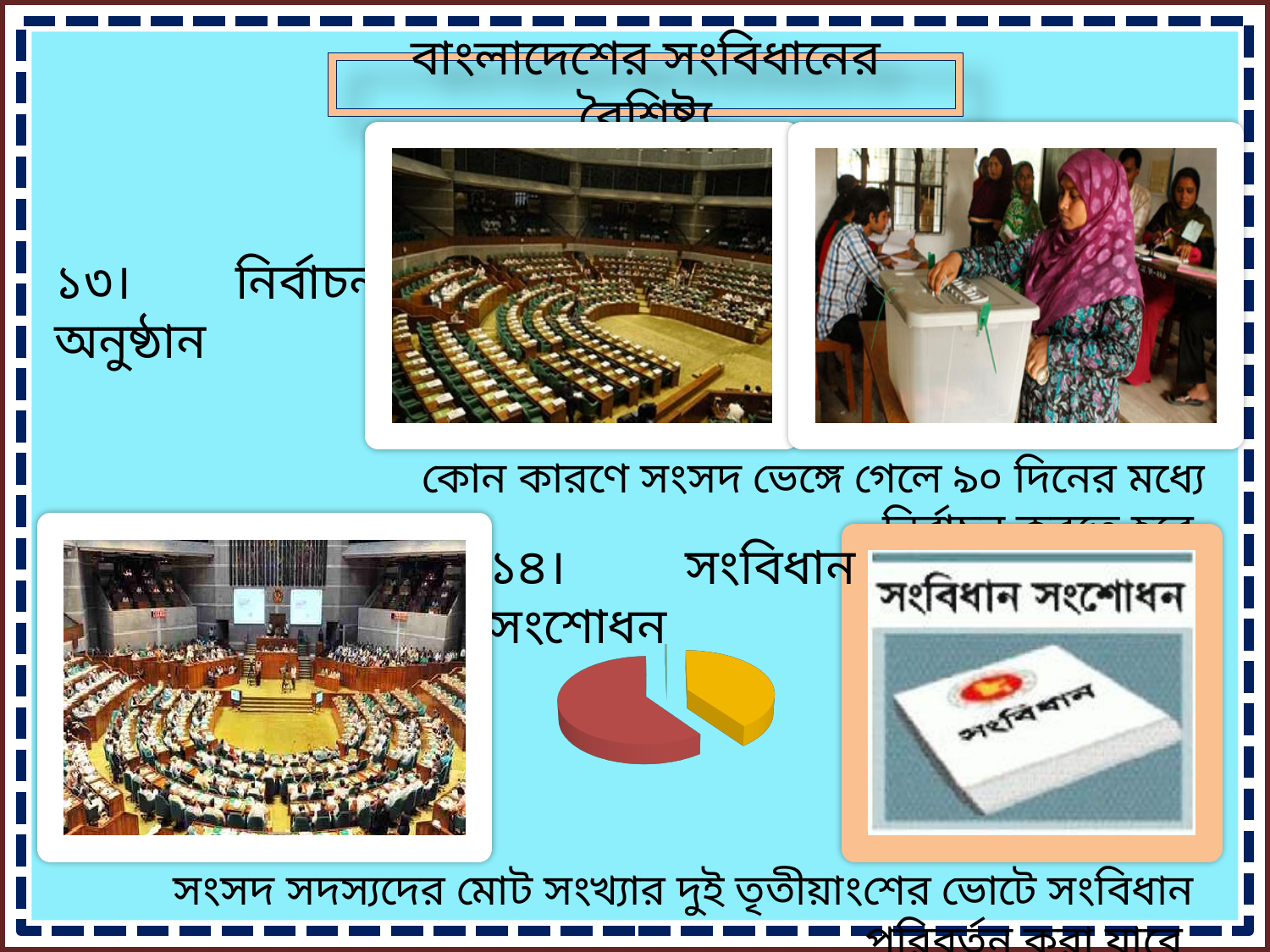
Which slice of the pie chart is larger, the red one or the yellow one? red Does the pie chart on the slide have a legend? No Which slice of the pie chart is pulled out (exploded) from the rest of the pie? the yellow slice Which colour slice takes up the largest share of the pie chart? red What kind of chart is shown on the slide next to the text '১৪। সংবিধান সংশোধন'? pie chart How many slices does the pie chart on the slide have? 2 Which colour slice takes up the smallest share of the pie chart? yellow